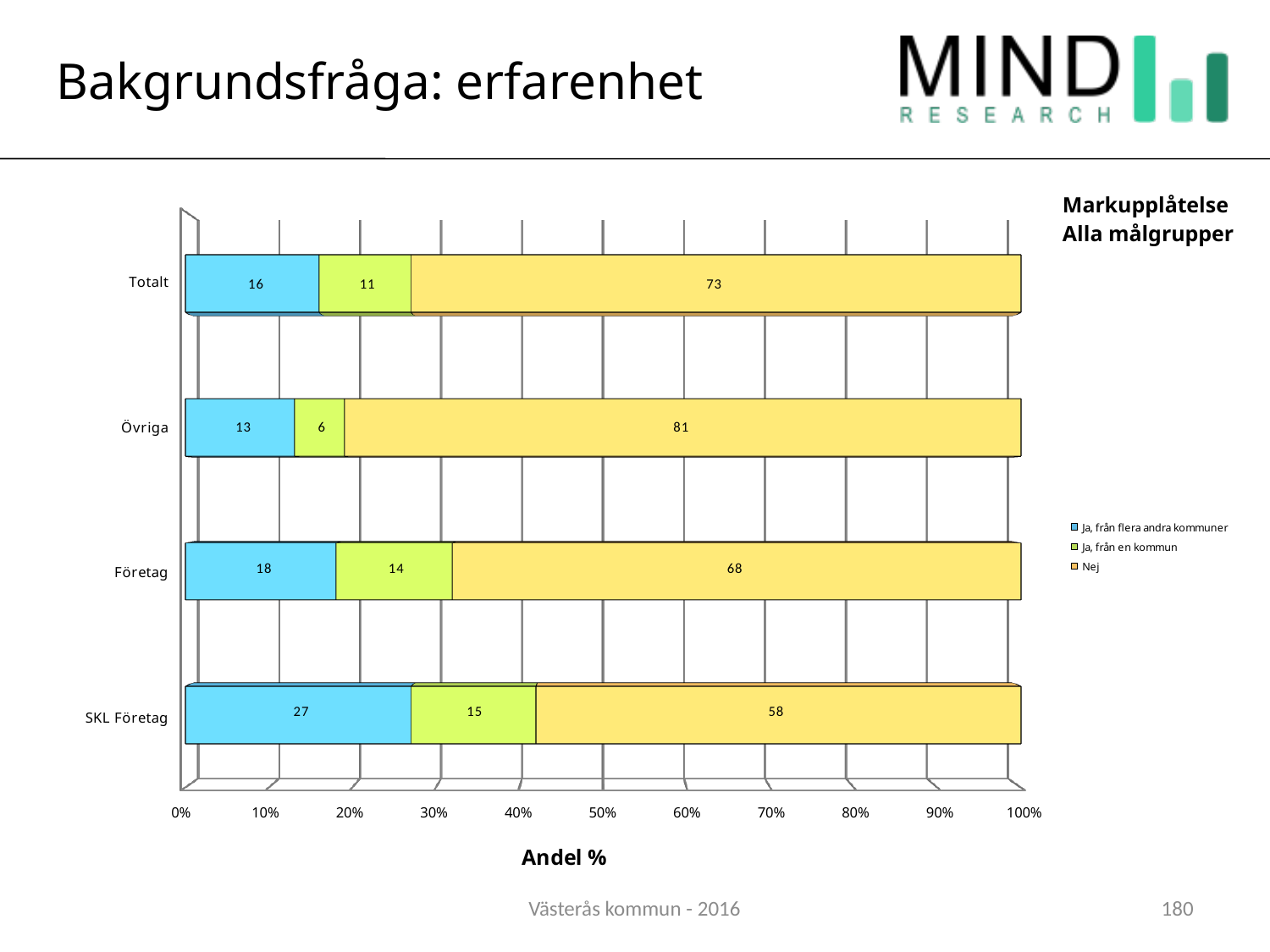
What is the difference between the "Nej" values for Övriga and SKL Företag? 23 How many series does the legend list? 3 What is the value for "Ja, från flera andra kommuner" in the SKL Företag bar? 27 Which is larger: the "Ja, från en kommun" value for Företag or for Totalt? Företag What kind of chart is shown on the slide? Stacked bar chart What is the value for "Ja, från en kommun" in the Övriga bar? 6 What is the total of the SKL Företag bar? 100 How many categories are shown on the y axis? 4 What is the label of the x axis? Andel % Which category has the lowest value for "Ja, från flera andra kommuner"? Övriga Which category has the highest value for "Nej"? Övriga What is the value for "Nej" in the Totalt bar? 73